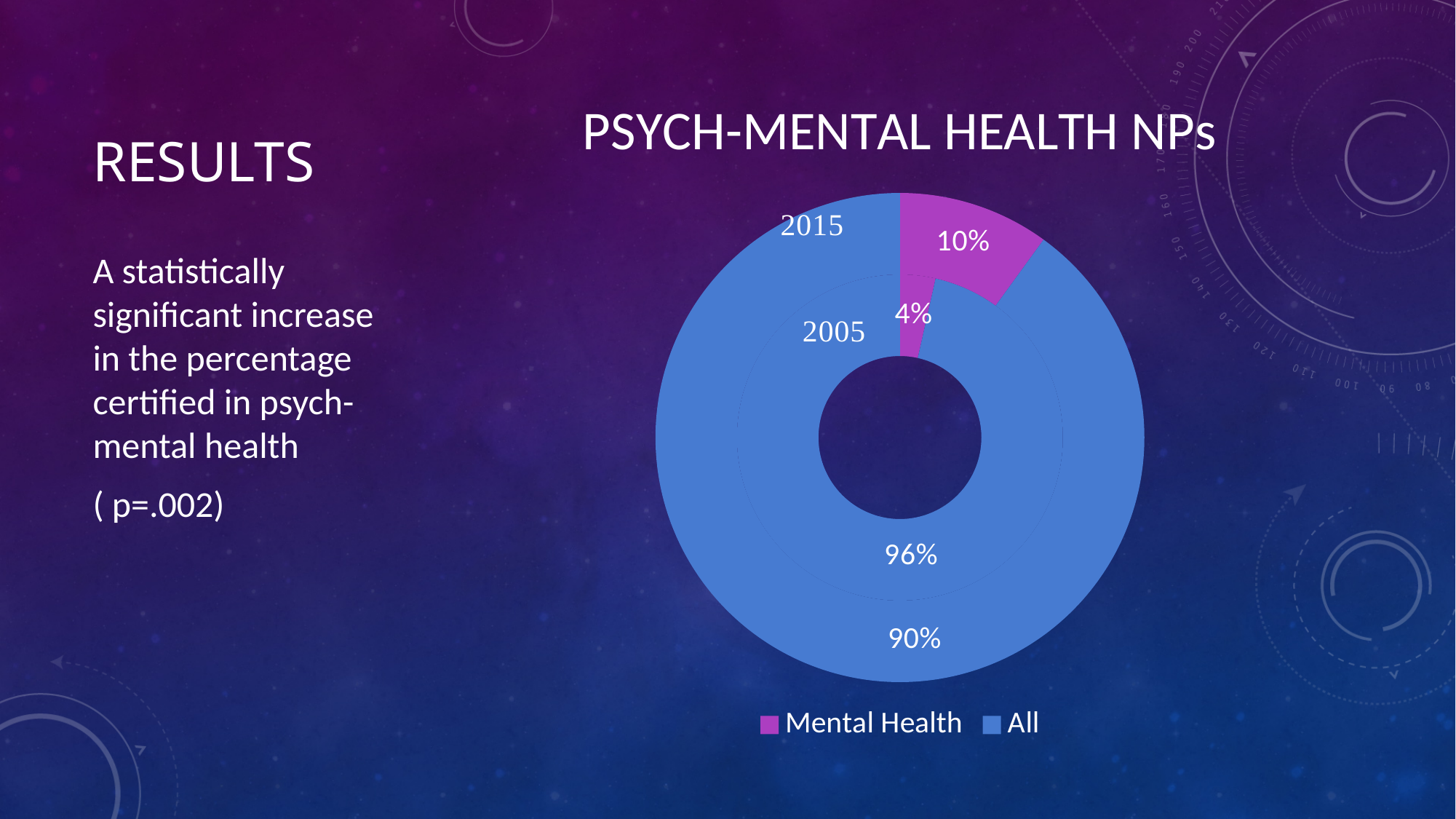
What kind of chart is shown on the slide? doughnut chart What are the two legend entries in the chart? Mental Health and All What percentage is shown for All in the 2005 ring? 96% What percentage is shown for All in the 2015 ring? 90% Which category has the smallest share in the 2005 ring? Mental Health By how many percentage points did the Mental Health share increase from 2005 to 2015? 6 Which year has the larger Mental Health share, 2005 or 2015? 2015 What percentage is shown for Mental Health in the 2005 ring? 4% How many entries does the chart legend list? 2 What is the title of the chart? PSYCH-MENTAL HEALTH NPs What percentage is shown for Mental Health in the 2015 ring? 10% How many years (rings) does the chart show? 2